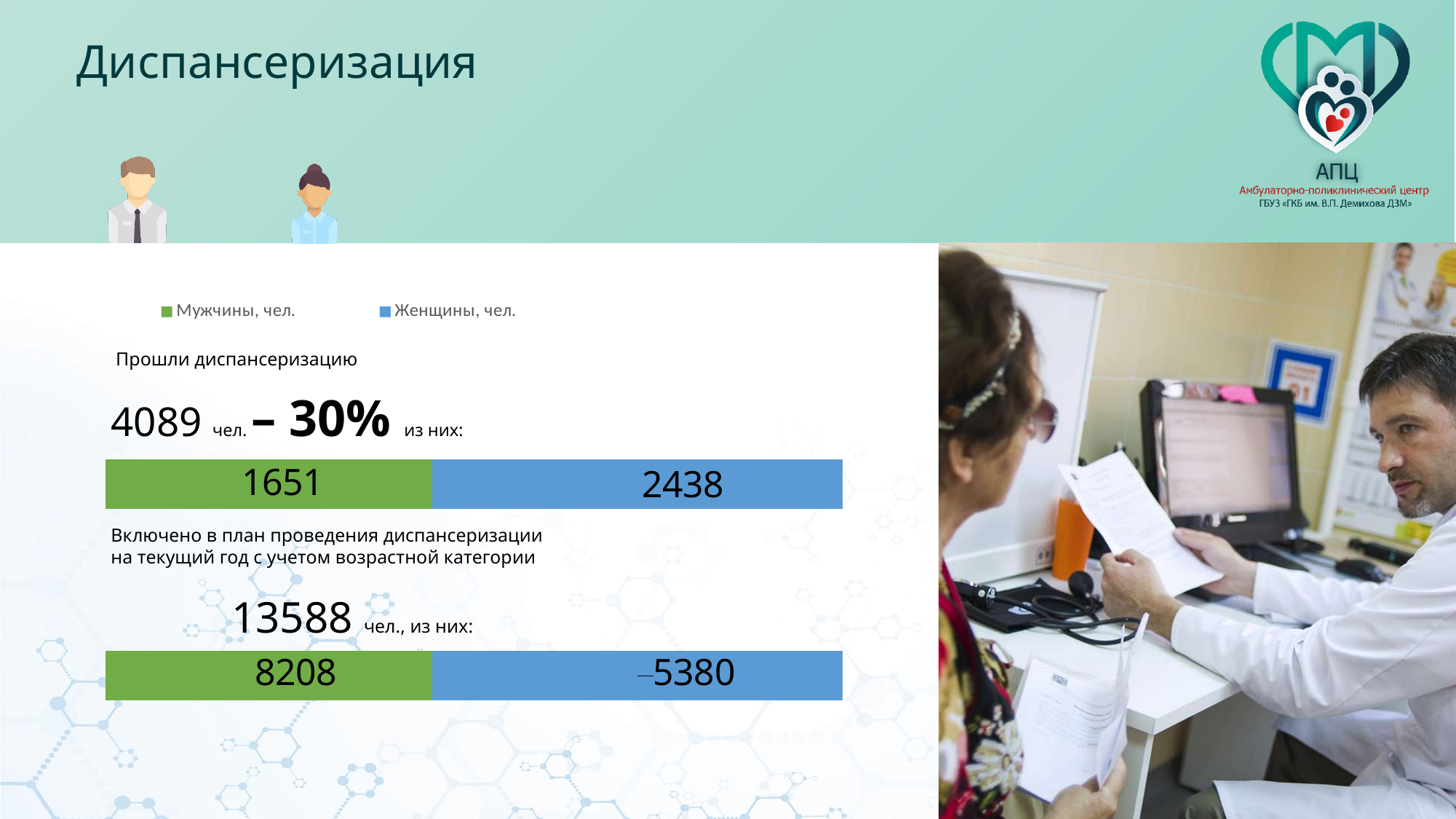
What are the two series named in the chart legend? Мужчины, чел. and Женщины, чел. What is the value for Мужчины, чел. in the bar for Прошли диспансеризацию? 1651 What is the difference between Мужчины, чел. and Женщины, чел. in the bar for Включено в план проведения диспансеризации? 2828 What is the value for Мужчины, чел. in the bar for Включено в план проведения диспансеризации? 8208 What kind of chart is shown on the slide? Stacked bar chart What is the value for Женщины, чел. in the bar for Прошли диспансеризацию? 2438 Which colour represents Женщины, чел. in the chart? Blue What is the value for Женщины, чел. in the bar for Включено в план проведения диспансеризации? 5380 In the bar for Прошли диспансеризацию, which is larger: Мужчины, чел. or Женщины, чел.? Женщины, чел. What is the total of the stacked bar for Включено в план проведения диспансеризации? 13588 What is the difference between Женщины, чел. and Мужчины, чел. in the bar for Прошли диспансеризацию? 787 How many series does the chart legend list? 2